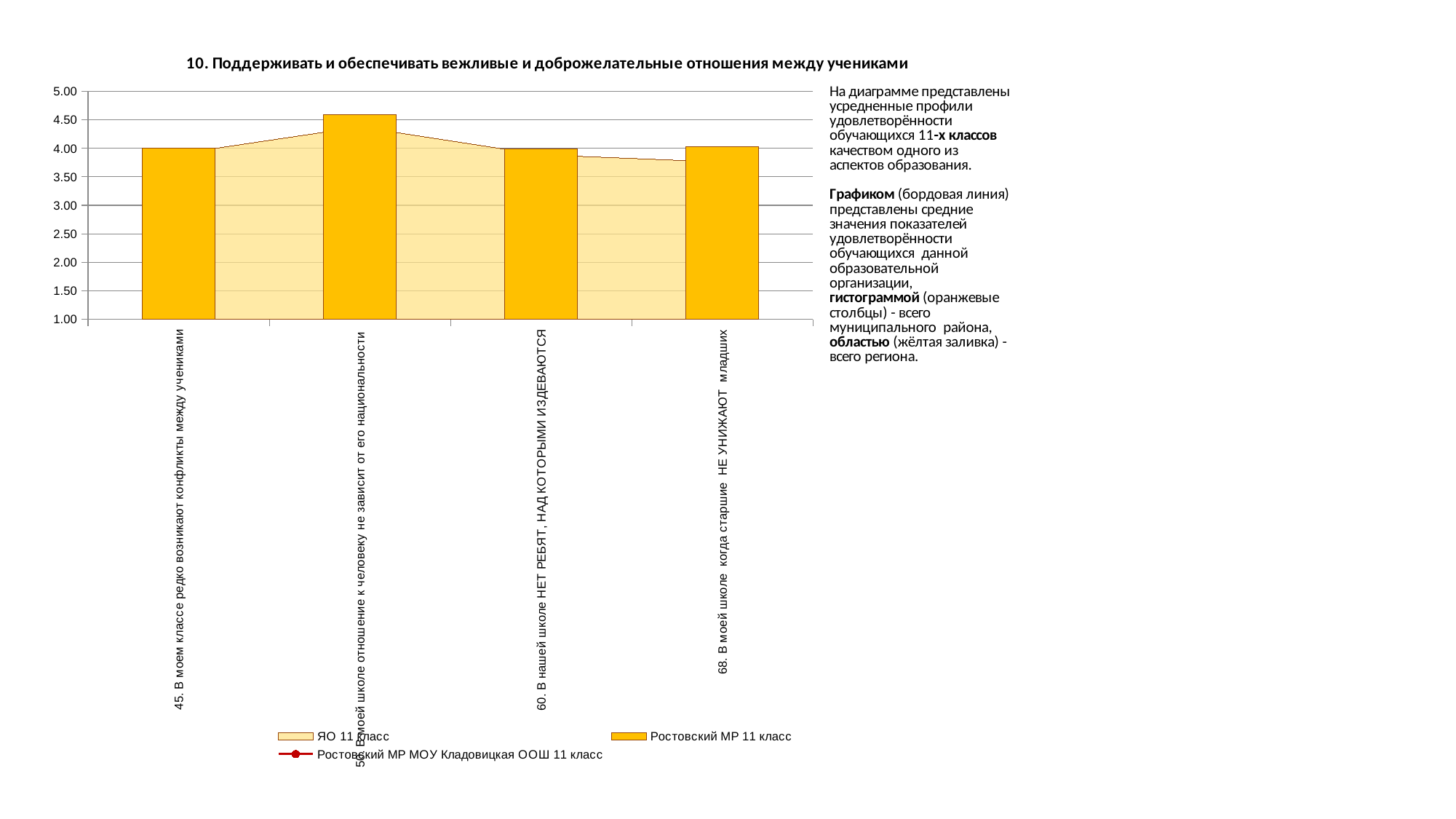
What is the title of the chart? 10. Поддерживать и обеспечивать вежливые и доброжелательные отношения между учениками What kind of chart is shown on the slide? bar chart (with an area series) Which series is shown in the legend with a red line marker? Ростовский МР МОУ Кладовицкая ООШ 11 класс What is the maximum value shown on the y axis? 5.00 Is the orange bar for '45. В моем классе редко возникают конфликты между учениками' greater or less than 3.50? greater Which category has the highest orange bar (Ростовский МР 11 класс)? В моей школе отношение к человеку не зависит от его национальности Which orange bar is taller: the one for '45. В моем классе редко возникают конфликты между учениками' or the one for 'В моей школе отношение к человеку не зависит от его национальности'? В моей школе отношение к человеку не зависит от его национальности How many categories (questions) are shown on the x axis? 4 Is the orange bar for 'В моей школе отношение к человеку не зависит от его национальности' greater or less than 4.50? greater Is the yellow area value (ЯО 11 класс) for '60. В нашей школе НЕТ РЕБЯТ, НАД КОТОРЫМИ ИЗДЕВАЮТСЯ' greater or less than 4.50? less How many series does the legend list? 3